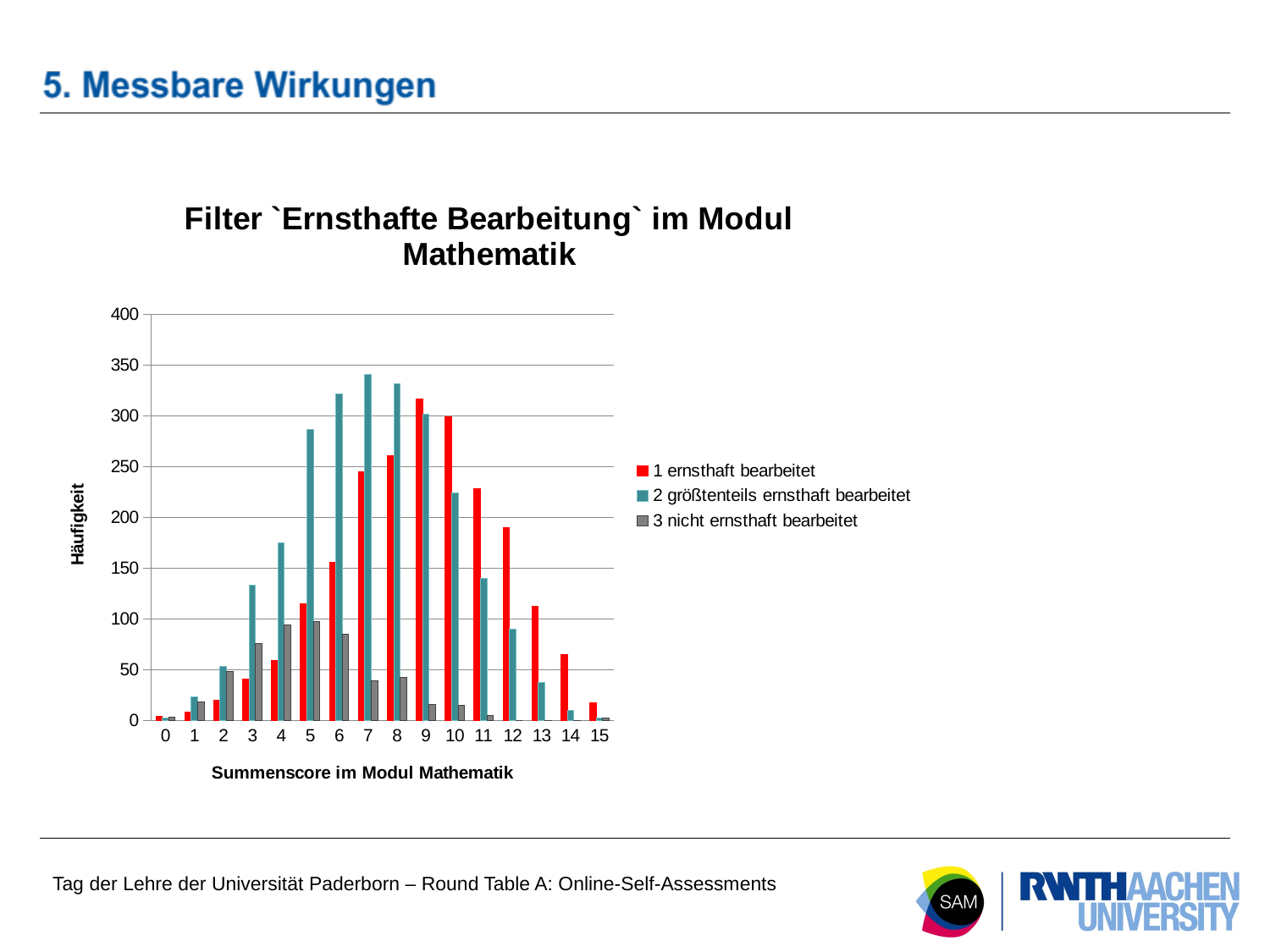
At Summenscore 12, which series has the larger value: '1 ernsthaft bearbeitet' or '2 größtenteils ernsthaft bearbeitet'? 1 ernsthaft bearbeitet How many series does the legend list? 3 Is the value for '3 nicht ernsthaft bearbeitet' at Summenscore 3 greater or less than 50? greater Is the value for '2 größtenteils ernsthaft bearbeitet' at Summenscore 5 greater or less than 250? greater What is the title of the y axis? Häufigkeit Is the value for '1 ernsthaft bearbeitet' at Summenscore 14 greater or less than 100? less How many Summenscore categories are shown on the x axis? 16 At which Summenscore is the value for '1 ernsthaft bearbeitet' highest? 9 Do the values for '1 ernsthaft bearbeitet' rise or fall from Summenscore 9 to Summenscore 15? fall What kind of chart is shown on the slide? bar chart At Summenscore 7, which series has the larger value: '1 ernsthaft bearbeitet' or '2 größtenteils ernsthaft bearbeitet'? 2 größtenteils ernsthaft bearbeitet